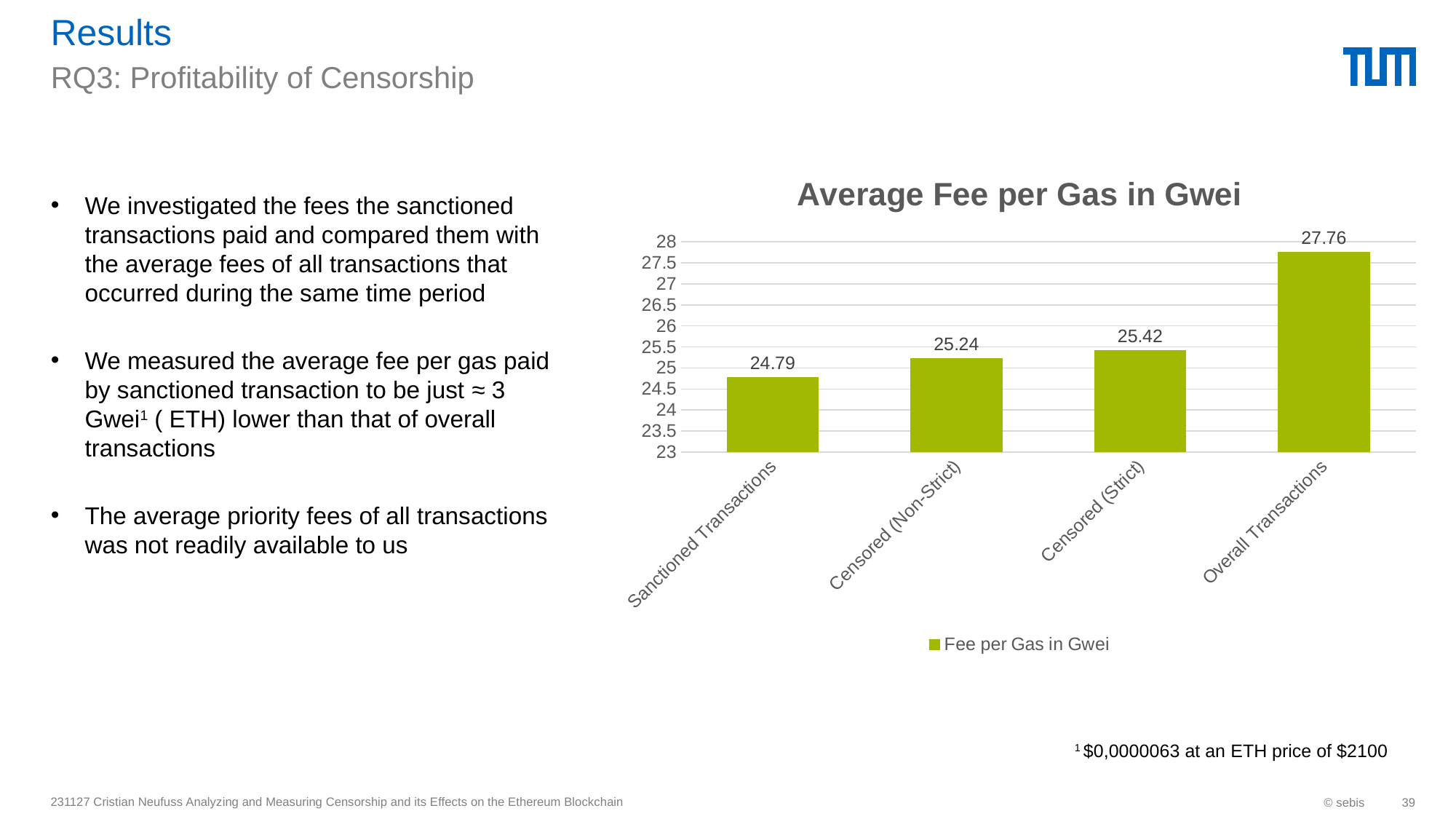
What is the title of the chart? Average Fee per Gas in Gwei What is the difference in average fee per gas between Overall Transactions and Sanctioned Transactions? 2.97 Which category has the lowest average fee per gas? Sanctioned Transactions Is the value for Overall Transactions greater or less than 27? greater What is the average fee per gas in Gwei for Overall Transactions? 27.76 How many categories are shown in the chart? 4 Which has a higher average fee per gas: Censored (Strict) or Censored (Non-Strict)? Censored (Strict) What is the average fee per gas in Gwei for Censored (Non-Strict) transactions? 25.24 What is the average fee per gas in Gwei for Sanctioned Transactions? 24.79 What is the average fee per gas in Gwei for Censored (Strict) transactions? 25.42 What type of chart is shown on the slide? Bar chart Which category has the highest average fee per gas? Overall Transactions